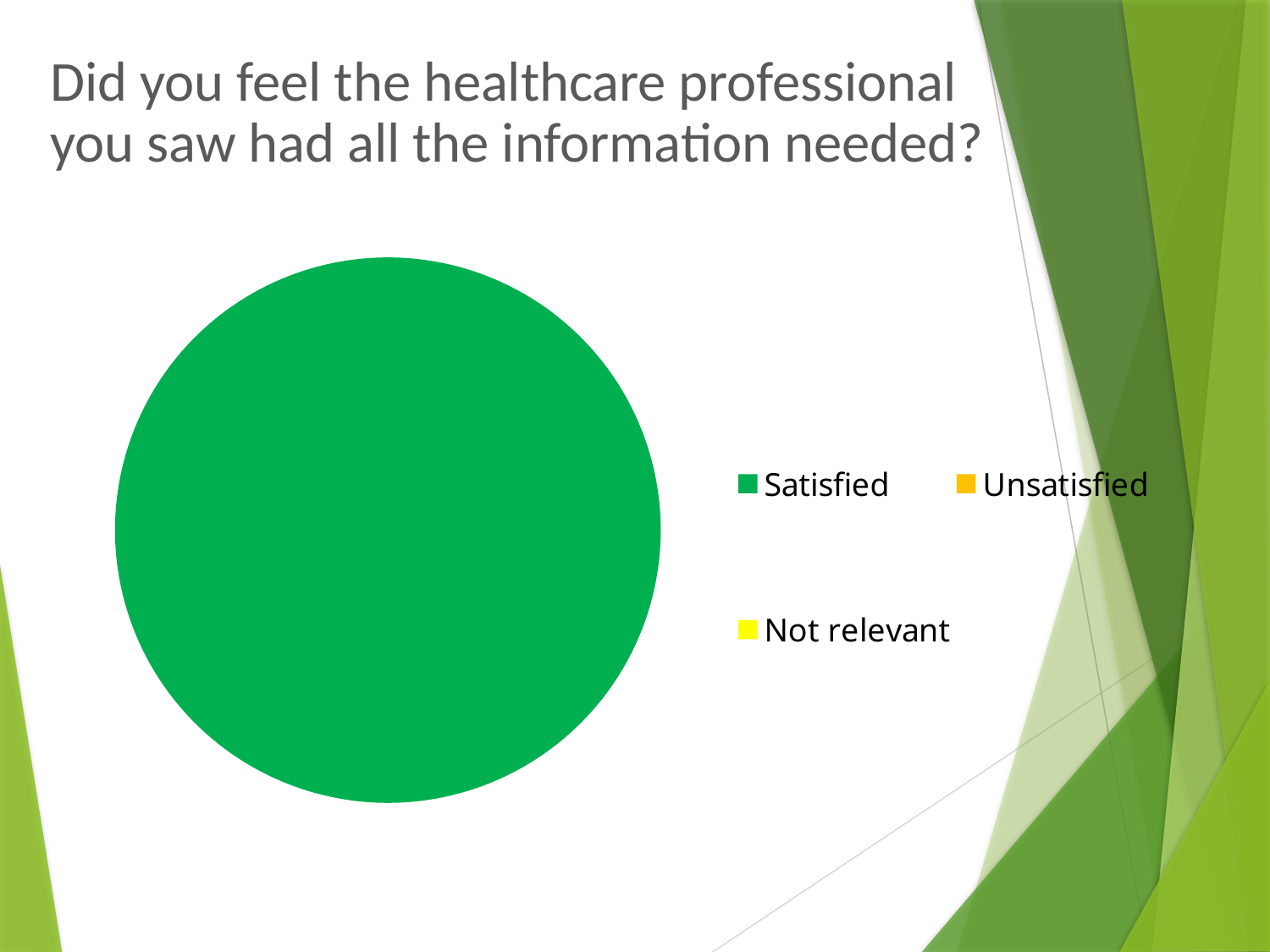
Which is larger in the pie chart, Satisfied or Unsatisfied? Satisfied What is the title of the slide containing the pie chart? Did you feel the healthcare professional you saw had all the information needed? Which is larger in the pie chart, Satisfied or Not relevant? Satisfied How many categories does the legend of the pie chart list? 3 Which category takes up the largest share of the pie chart? Satisfied What colour represents the Satisfied category in the legend? green What kind of chart is shown on the slide? pie chart